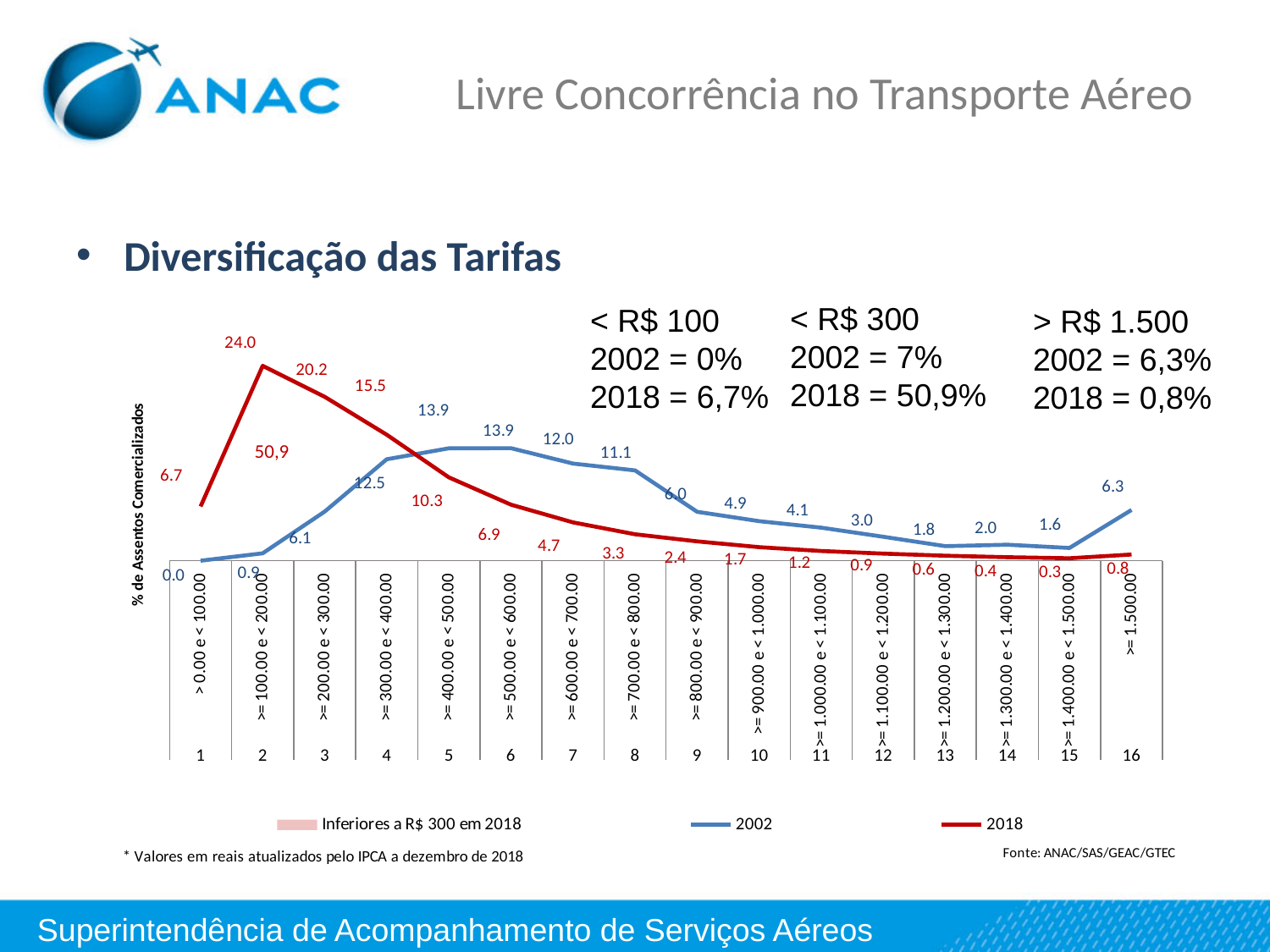
What is the 2018 value for the fare band ">= 100.00 e < 200.00"? 24.0 Which fare band has the lowest value in the 2018 series? >= 1.400.00 e < 1.500.00 How many entries does the chart legend list? 3 What is the 2002 value for the fare band ">= 300.00 e < 400.00"? 12.5 From the fare band ">= 100.00 e < 200.00" to ">= 1.400.00 e < 1.500.00", does the 2018 line rise or fall? Fall What is the difference between the 2018 and 2002 values for the fare band ">= 100.00 e < 200.00"? 23.1 How many fare bands are shown on the x axis of the chart? 16 What kind of chart is used to show the distribution of seats by fare band? Line chart What is the 2018 value for the fare band ">= 1.500.00"? 0.8 What is the 2002 value for the fare band ">= 1.500.00"? 6.3 Which fare band has the highest value in the 2018 series? >= 100.00 e < 200.00 For the fare band ">= 400.00 e < 500.00", which series has the larger value, 2002 or 2018? 2002